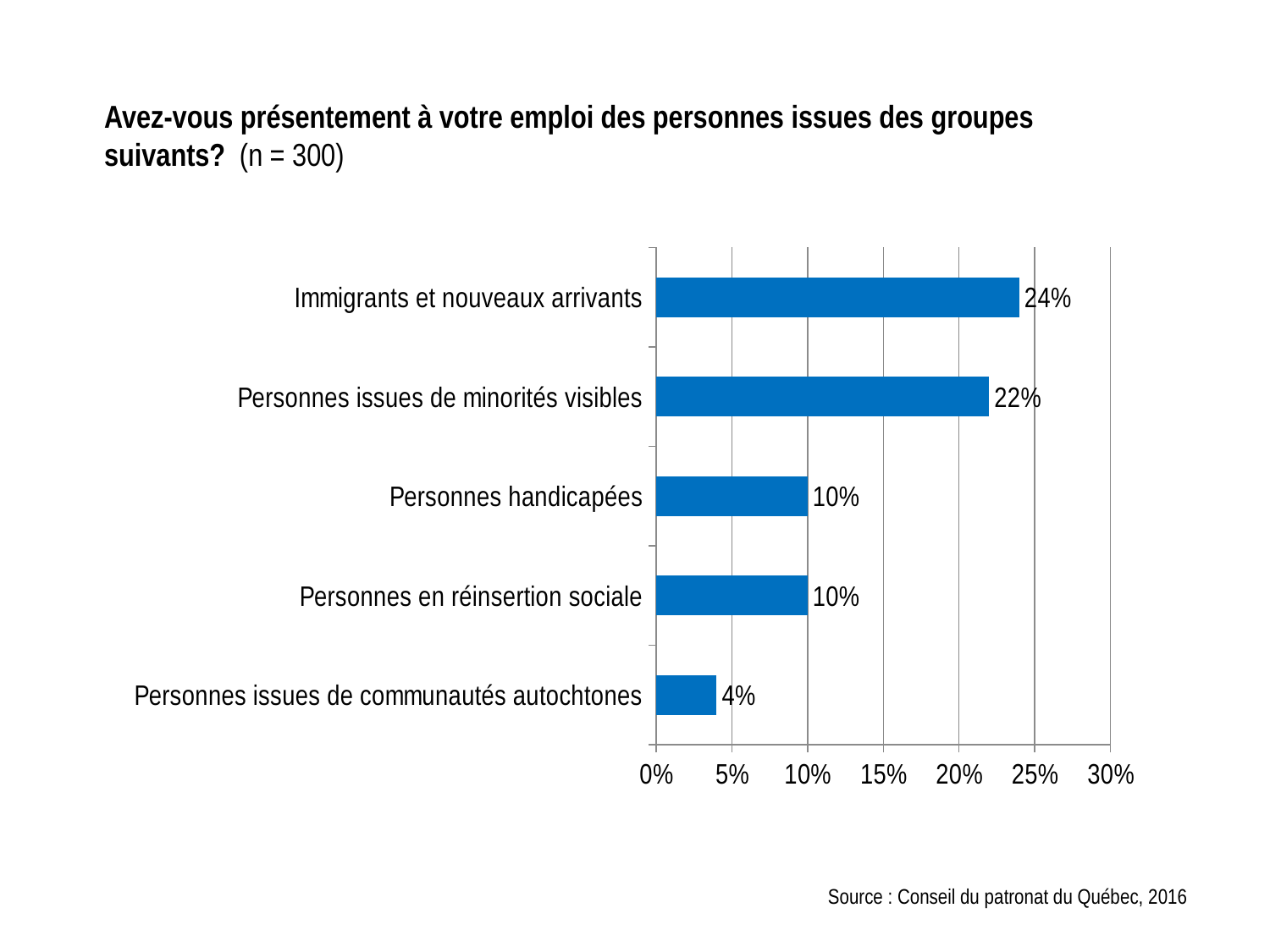
What kind of chart is shown on the slide? Bar chart What is the difference between the values for Personnes handicapées and Personnes issues de communautés autochtones? 6% What is the sample size (n) stated in the chart title? 300 Which category has the lowest value? Personnes issues de communautés autochtones Which category has the highest value? Immigrants et nouveaux arrivants What is the value for Immigrants et nouveaux arrivants? 24% What is the difference between the values for Immigrants et nouveaux arrivants and Personnes issues de minorités visibles? 2% Which is larger, the value for Personnes issues de minorités visibles or the value for Personnes en réinsertion sociale? Personnes issues de minorités visibles What is the value for Personnes issues de minorités visibles? 22% How many categories are shown in the chart? 5 What is the value for Personnes issues de communautés autochtones? 4% What is the value for Personnes handicapées? 10%